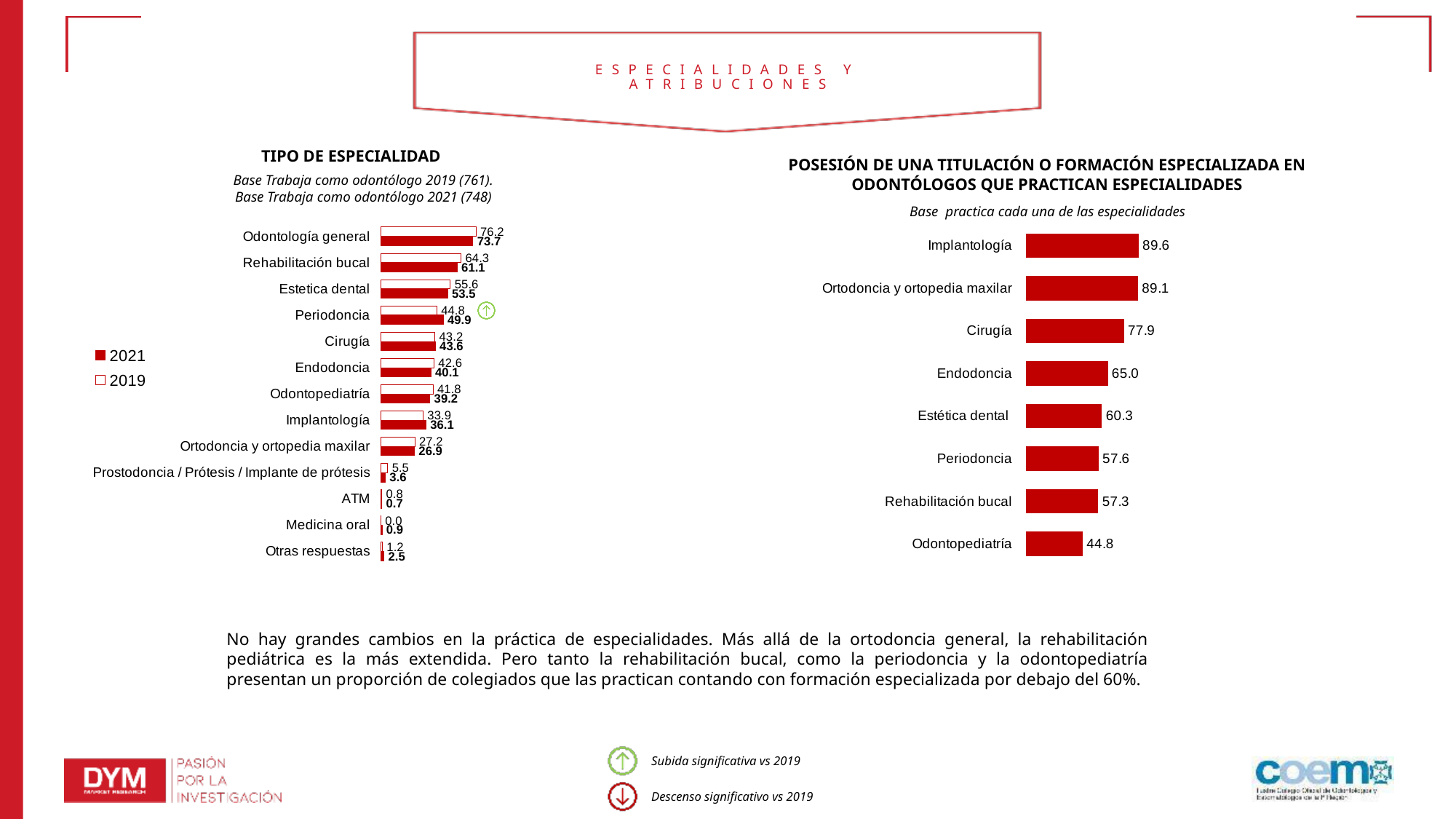
In the 'POSESIÓN DE UNA TITULACIÓN O FORMACIÓN ESPECIALIZADA' chart, what is the value for Cirugía? 77.9 In the 'POSESIÓN DE UNA TITULACIÓN O FORMACIÓN ESPECIALIZADA' chart, which category has the lowest value? Odontopediatría In the 'TIPO DE ESPECIALIDAD' chart, which is larger for Implantología: the 2021 value or the 2019 value? 2021 In the 'TIPO DE ESPECIALIDAD' chart, what is the 2019 value for Periodoncia? 44.8 In the 'TIPO DE ESPECIALIDAD' chart, which category has the lowest 2021 value? ATM In the 'TIPO DE ESPECIALIDAD' chart, what is the 2021 value for Odontología general? 73.7 In the 'POSESIÓN DE UNA TITULACIÓN O FORMACIÓN ESPECIALIZADA' chart, which category has the highest value? Implantología In the 'TIPO DE ESPECIALIDAD' chart, how many categories are shown? 13 What kind of chart is the 'POSESIÓN DE UNA TITULACIÓN O FORMACIÓN ESPECIALIZADA' chart? Bar chart In the 'POSESIÓN DE UNA TITULACIÓN O FORMACIÓN ESPECIALIZADA' chart, what is the difference between Implantología and Endodoncia? 24.6 In the 'TIPO DE ESPECIALIDAD' chart, what is the difference between the 2019 and 2021 values for Endodoncia? 2.5 In the 'TIPO DE ESPECIALIDAD' chart, how many series does the legend list? 2